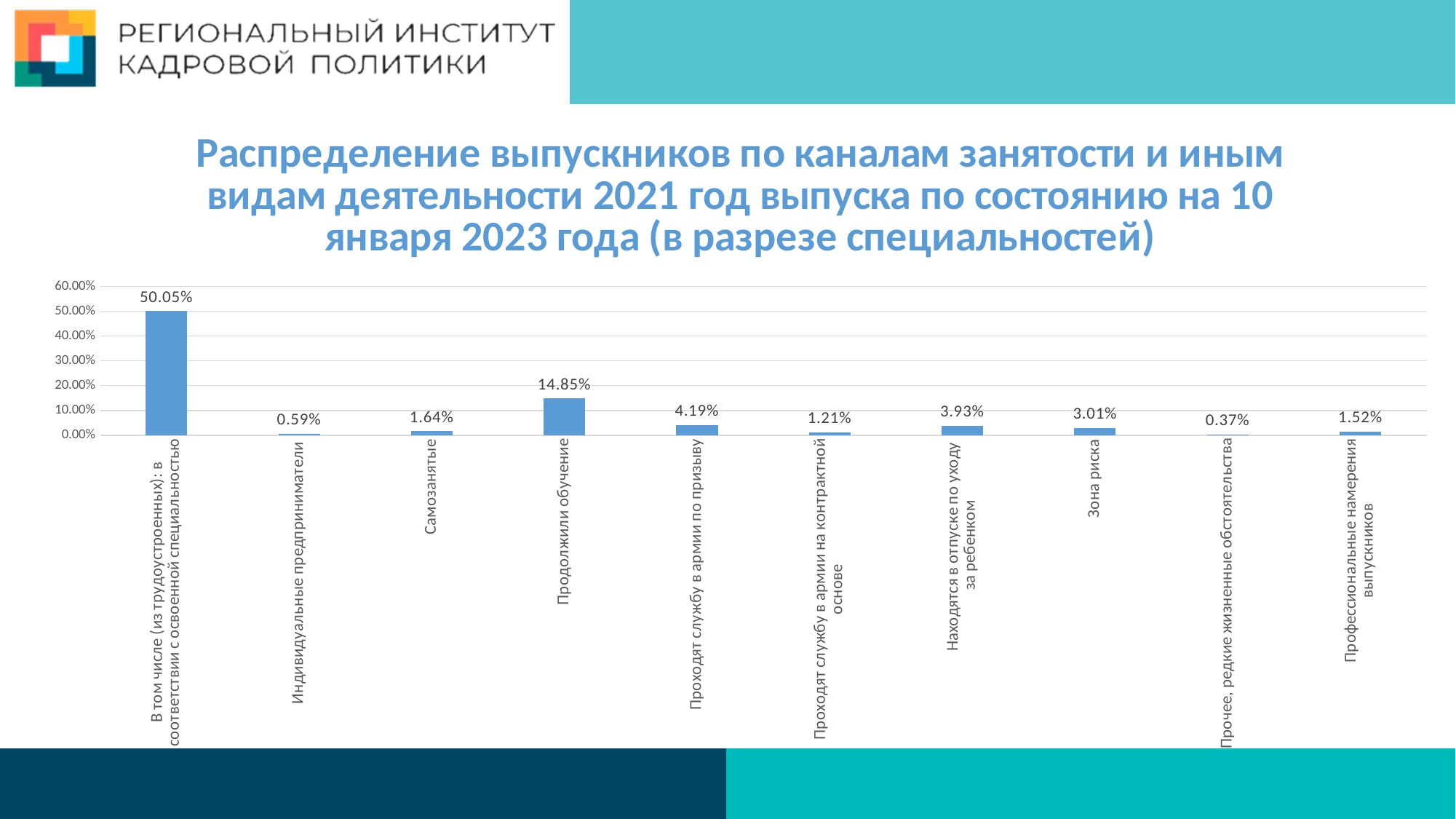
Which category has the lowest value? Прочее, редкие жизненные обстоятельства What is the difference between the values for "Самозанятые" and "Индивидуальные предприниматели"? 1.05% What is the difference between the values for "В том числе (из трудоустроенных): в соответствии с освоенной специальностью" and "Продолжили обучение"? 35.20% Which category has the highest value? В том числе (из трудоустроенных): в соответствии с освоенной специальностью What is the value for "Находятся в отпуске по уходу за ребенком"? 3.93% How many categories are plotted in the chart? 10 What is the value for "Продолжили обучение"? 14.85% Which is larger: the value for "Проходят службу в армии по призыву" or the value for "Проходят службу в армии на контрактной основе"? Проходят службу в армии по призыву What kind of chart is shown on the slide? bar chart What is the value for "Зона риска"? 3.01% What is the value for "Самозанятые"? 1.64% Is the value for "Продолжили обучение" greater or less than 10.00%? greater